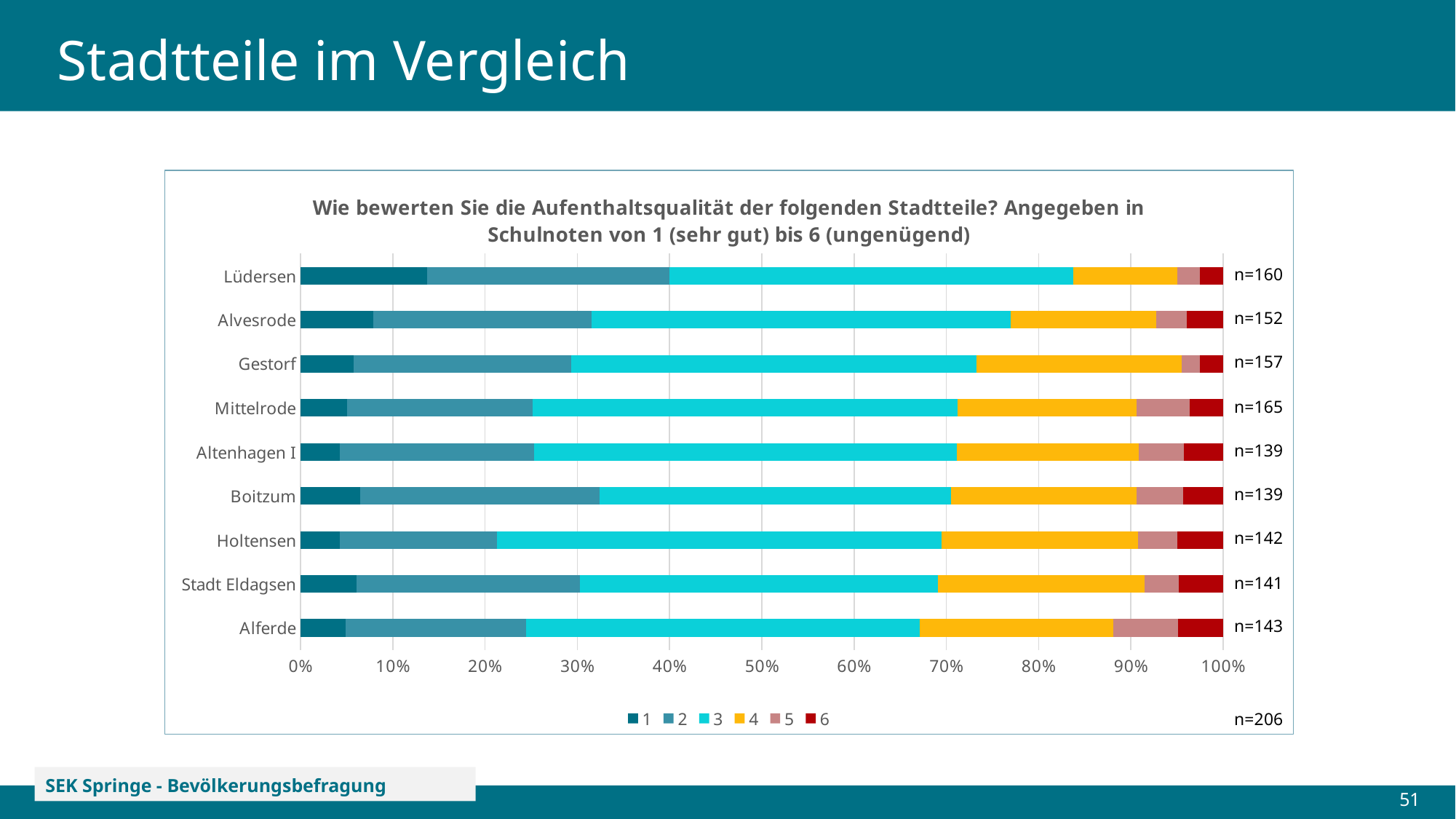
What overall n value is shown at the bottom right of the chart? n=206 What is the n value shown for Mittelrode? n=165 Is the share of grade 1 for Lüdersen greater or less than 10%? greater What is the difference between the n values of Mittelrode and Lüdersen? 5 Which district has the highest n value? Mittelrode How many districts (categories) are shown in the chart? 9 What kind of chart is shown on the slide? stacked bar chart Which district has the larger share of grade 1, Lüdersen or Alferde? Lüdersen What is the n value shown for Stadt Eldagsen? n=141 What is the n value shown for Lüdersen? n=160 How many series does the legend list? 6 Is the share of grade 1 for Alferde greater or less than 10%? less